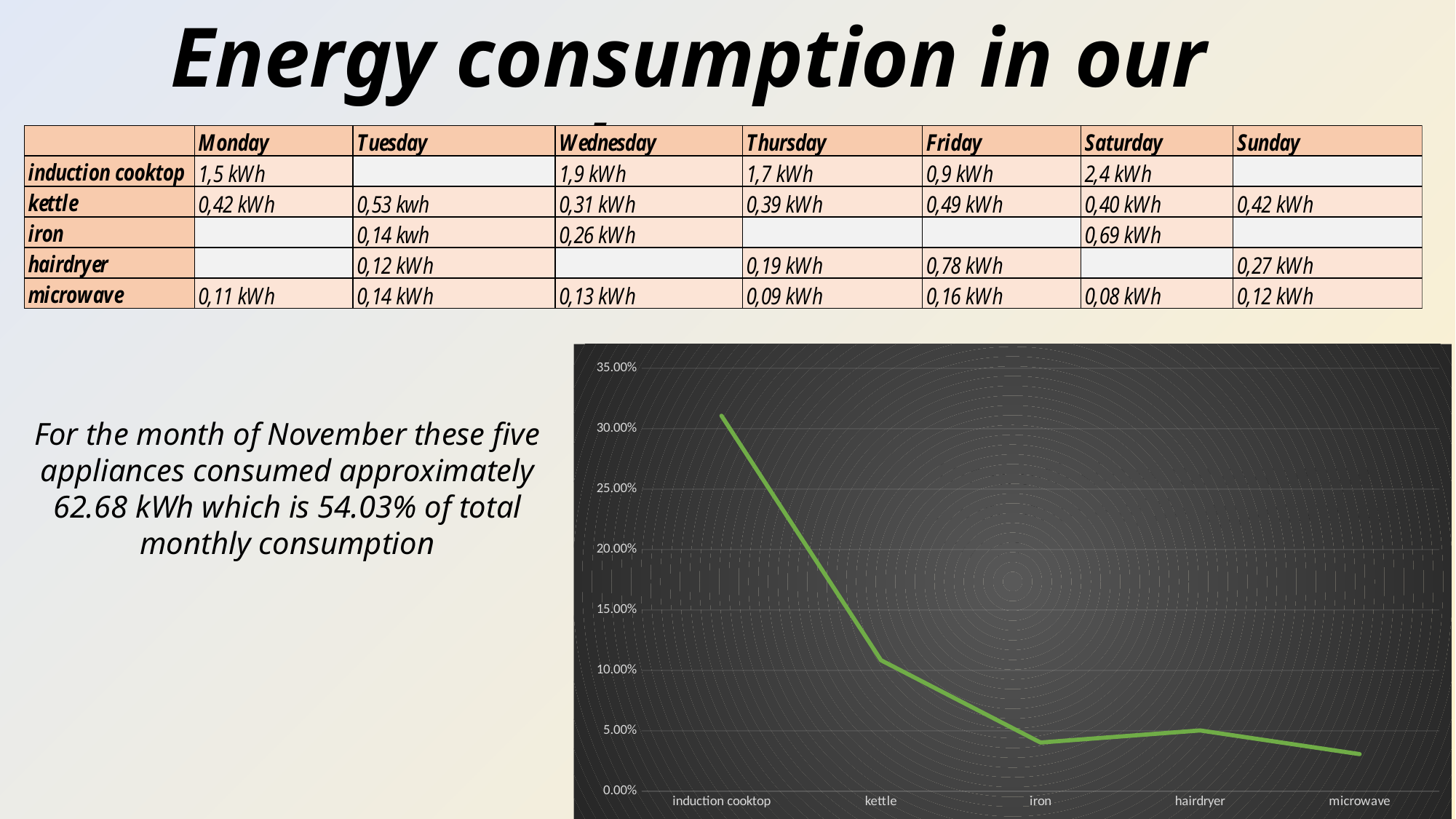
What colour is the line in the chart? green How many appliance categories are plotted on the x axis of the chart? 5 Which has a larger value, induction cooktop or kettle? induction cooktop Is the value for microwave greater or less than 5.00%? less Is the value for induction cooktop greater or less than 25.00%? greater Does the line generally rise or fall from induction cooktop to microwave? fall Which has a larger value, hairdryer or microwave? hairdryer Which appliance has the highest value in the chart? induction cooktop Is the value for kettle greater or less than 5.00%? greater What kind of chart is shown on the slide? line chart